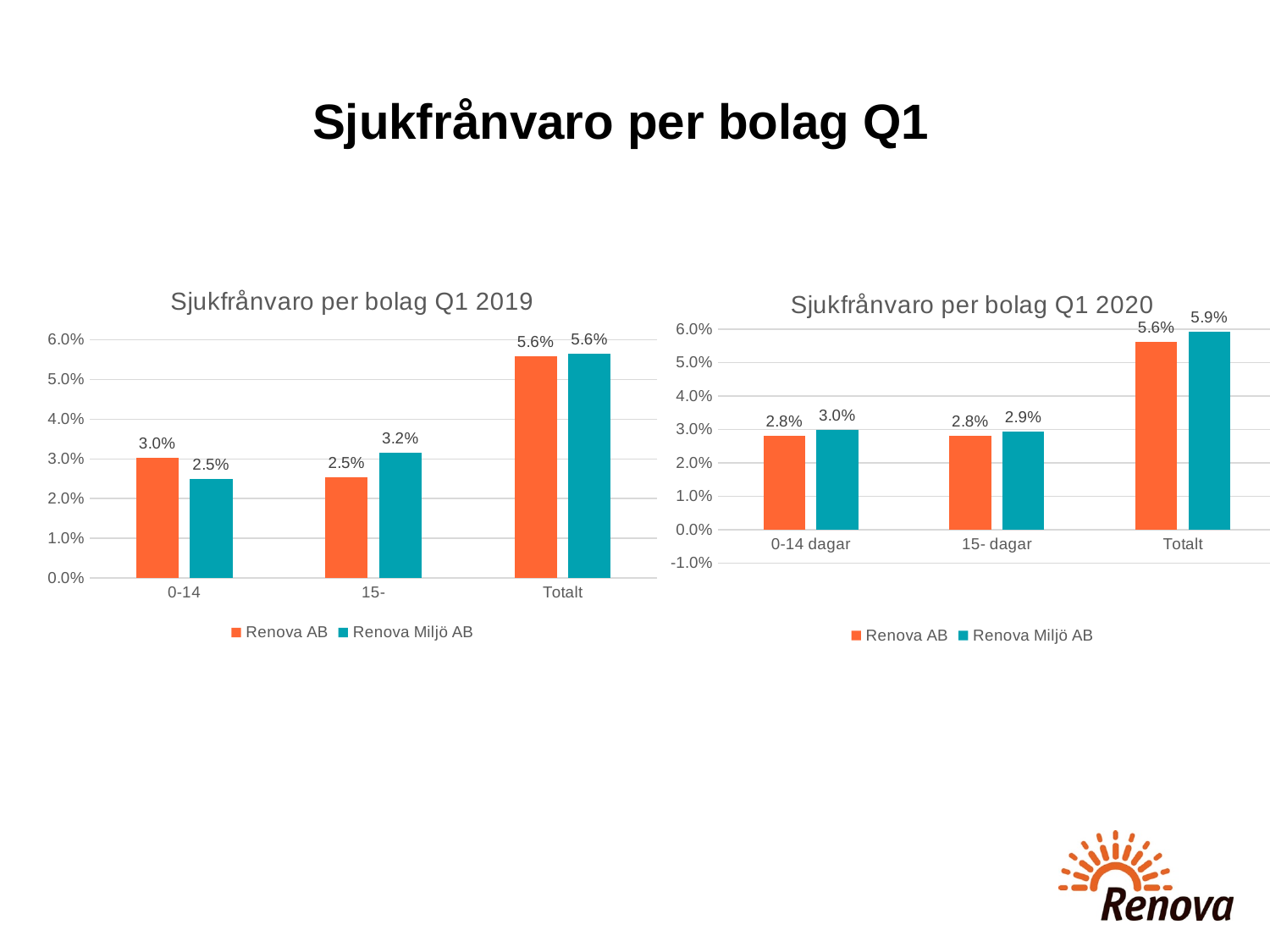
In the 'Sjukfrånvaro per bolag Q1 2019' chart, which category has the lowest value for Renova AB? 15- In the 'Sjukfrånvaro per bolag Q1 2020' chart, which is larger in the 0-14 dagar category, Renova AB or Renova Miljö AB? Renova Miljö AB In the 'Sjukfrånvaro per bolag Q1 2020' chart, what is the value for Renova AB in the 15- dagar category? 2.8% What kind of chart is the 'Sjukfrånvaro per bolag Q1 2019' chart? Bar chart In the 'Sjukfrånvaro per bolag Q1 2020' chart, what is the value for Renova Miljö AB in the Totalt category? 5.9% How many series does the legend of the 'Sjukfrånvaro per bolag Q1 2019' chart list? 2 In the 'Sjukfrånvaro per bolag Q1 2020' chart, what is the difference between Renova Miljö AB and Renova AB in the Totalt category? 0.3% In the 'Sjukfrånvaro per bolag Q1 2019' chart, which category has the highest value for Renova Miljö AB? Totalt In the 'Sjukfrånvaro per bolag Q1 2019' chart, what is the difference between Renova AB and Renova Miljö AB in the 0-14 category? 0.5% In the 'Sjukfrånvaro per bolag Q1 2019' chart, what is the value for Renova Miljö AB in the 15- category? 3.2% How many categories are shown on the x axis of the 'Sjukfrånvaro per bolag Q1 2020' chart? 3 In the 'Sjukfrånvaro per bolag Q1 2019' chart, what is the value for Renova AB in the 0-14 category? 3.0%